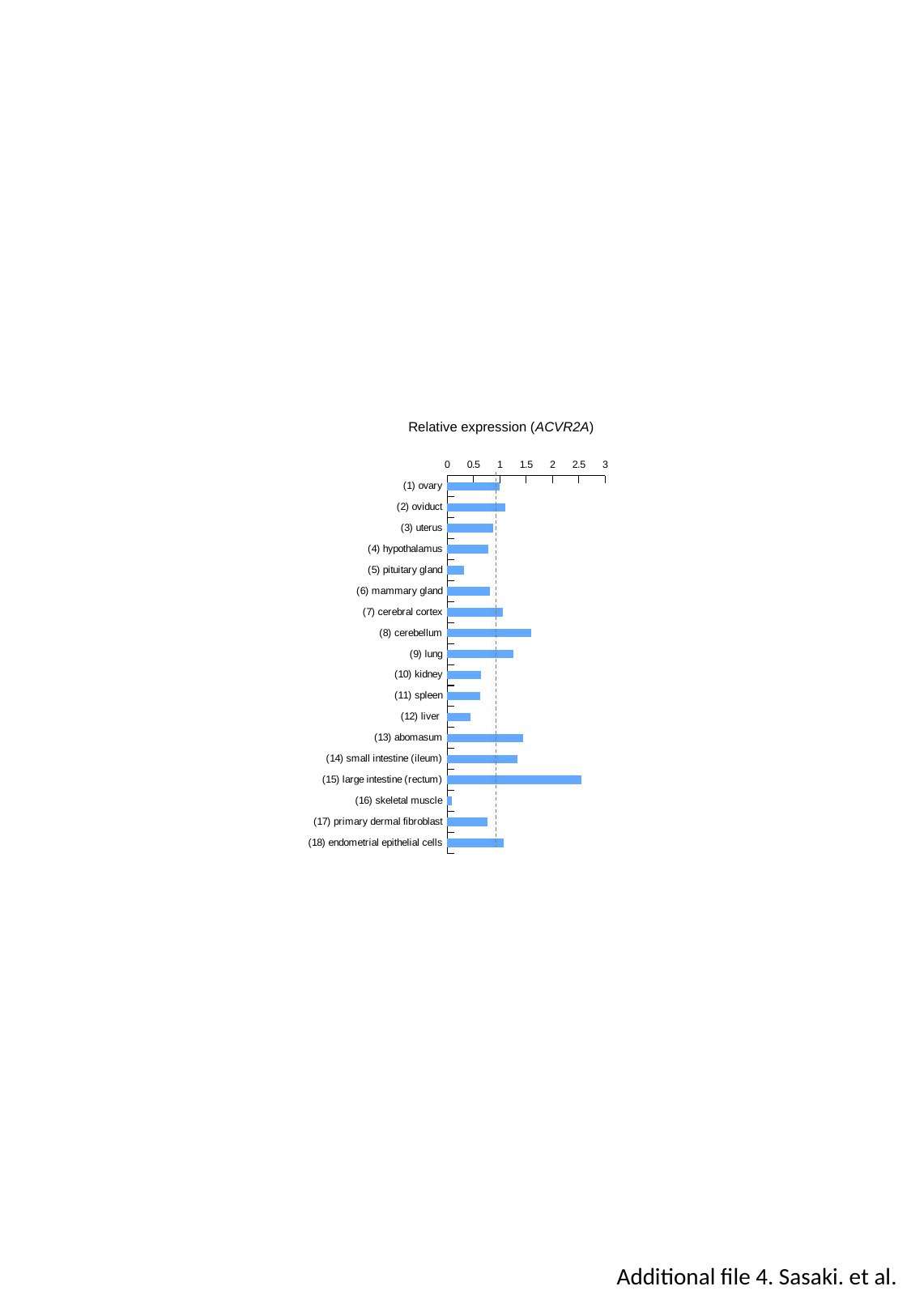
What kind of chart is shown on the slide? bar chart Is the value for (15) large intestine (rectum) greater or less than 2? greater How many tissue/cell categories are plotted in the chart? 18 Which category has the highest relative expression? (15) large intestine (rectum) At what x-axis value is the vertical dashed reference line drawn? 1 Which has the larger relative expression, (8) cerebellum or (9) lung? (8) cerebellum Is the value for (13) abomasum greater or less than 1? greater What is the title of the chart? Relative expression (ACVR2A) Is the value for (5) pituitary gland greater or less than 0.5? less Which has the larger relative expression, (12) liver or (16) skeletal muscle? (12) liver Which category has the lowest relative expression? (16) skeletal muscle